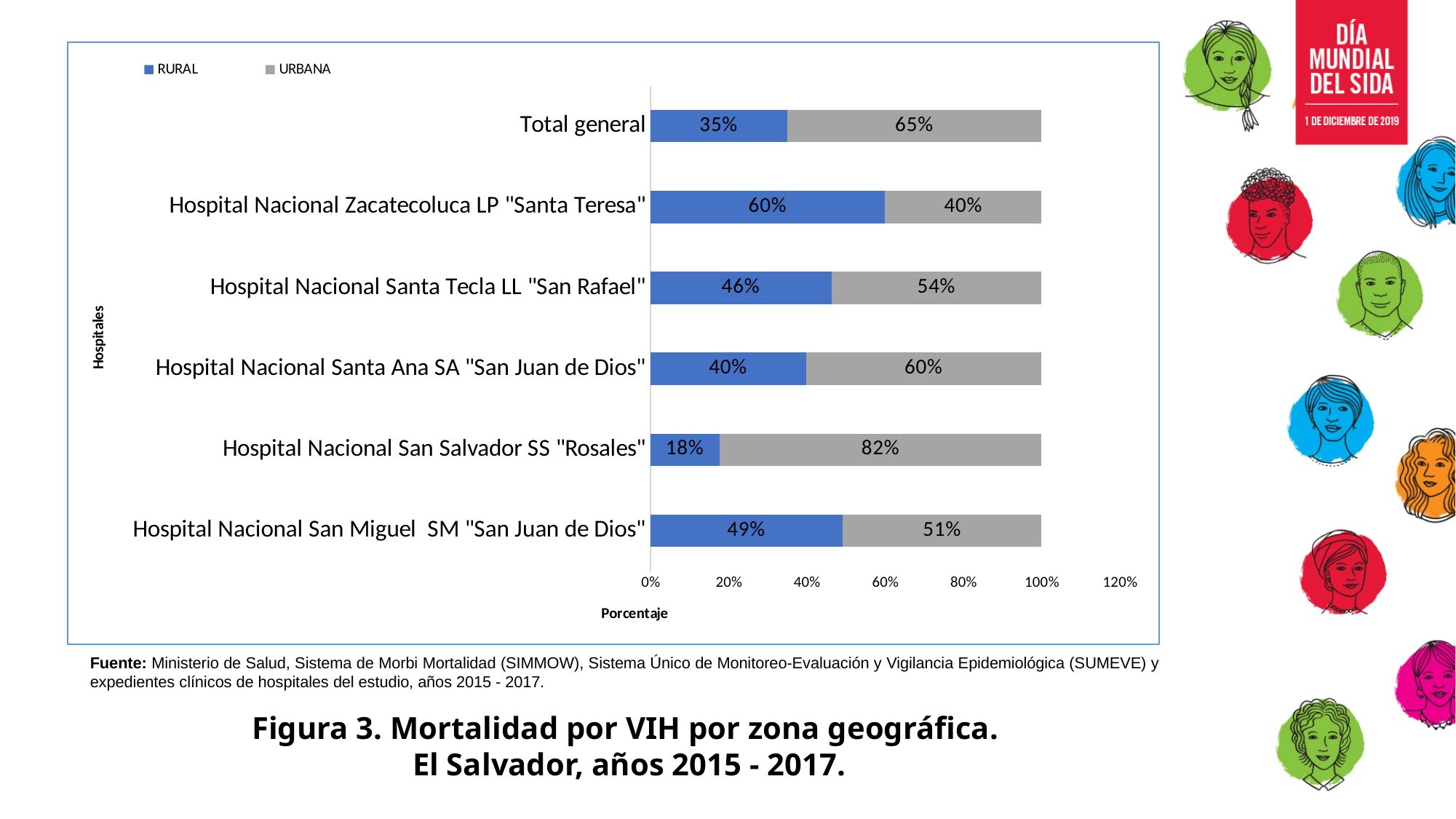
What is the difference between the URBANA and RURAL values for Hospital Nacional San Salvador SS "Rosales"? 64% What kind of chart is shown on the slide? Stacked bar chart What is the RURAL value for Hospital Nacional San Salvador SS "Rosales"? 18% How many categories are shown on the y axis of the chart? 6 What is the URBANA value for Hospital Nacional Santa Tecla LL "San Rafael"? 54% Which is larger for Hospital Nacional Santa Ana SA "San Juan de Dios": the RURAL value or the URBANA value? URBANA How many series does the legend list? 2 Which category has the lowest URBANA value? Hospital Nacional Zacatecoluca LP "Santa Teresa" Is the RURAL value for Hospital Nacional San Miguel SM "San Juan de Dios" greater or less than 40%? greater Which category has the highest RURAL value? Hospital Nacional Zacatecoluca LP "Santa Teresa" What is the total of the stacked bar for Hospital Nacional Santa Tecla LL "San Rafael"? 100% What is the RURAL value for Total general? 35%